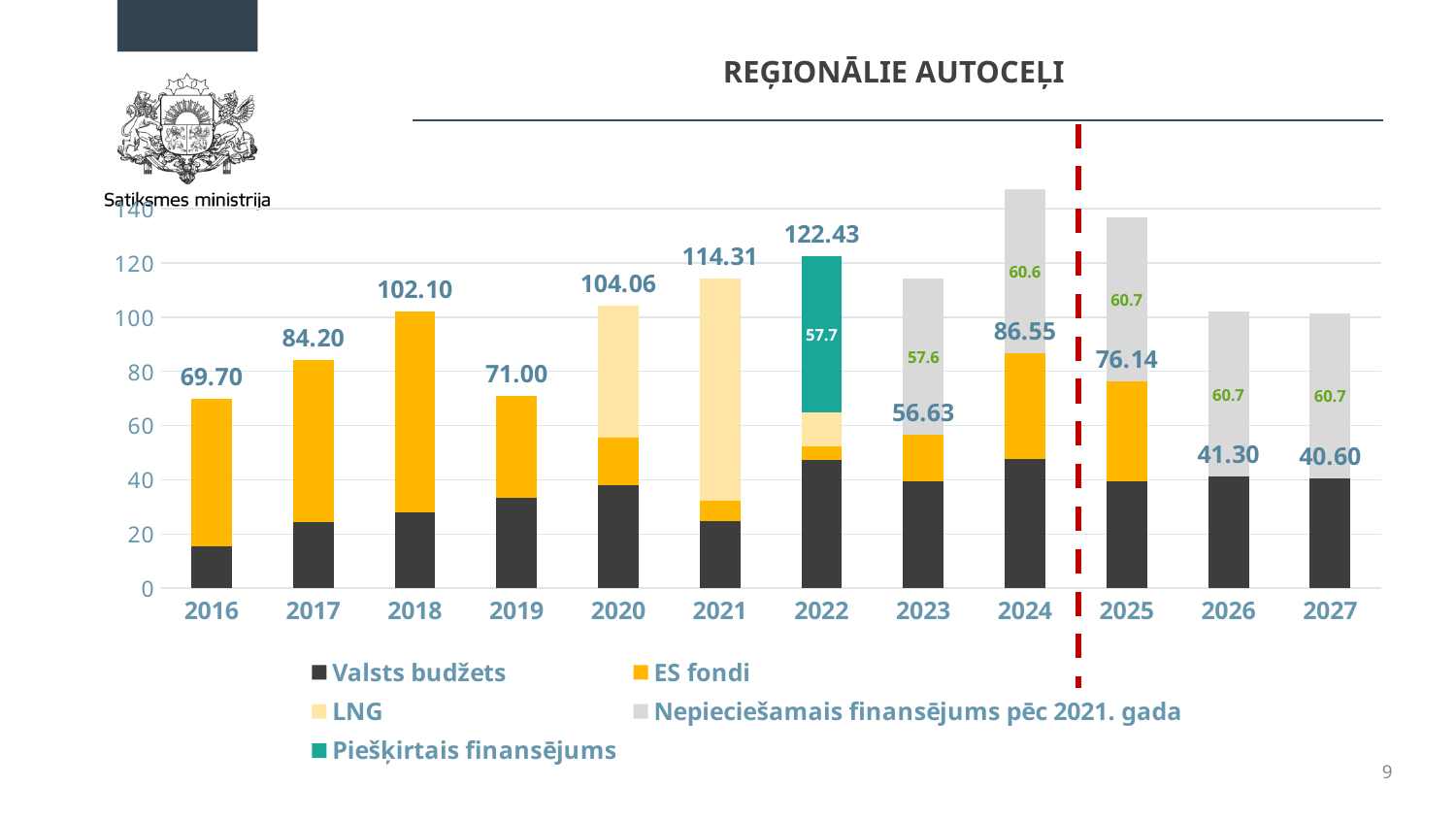
Which year has the lowest labelled value in blue? 2027 Which year has the tallest bar overall? 2024 Which year has the larger labelled value, 2020 or 2021? 2021 What is the difference between the labelled values for 2017 and 2016? 14.50 What value is printed on the grey segment of the 2024 bar? 60.6 What is the value labelled on the bar for 2018? 102.10 Is the total height of the 2019 bar greater or less than 80? less What is the value labelled on the bar for 2022? 122.43 How many years are shown on the x axis? 12 Do the labelled values rise or fall from 2016 to 2018? Rise What kind of chart is shown on the slide? Stacked bar chart How many series does the legend list? 5